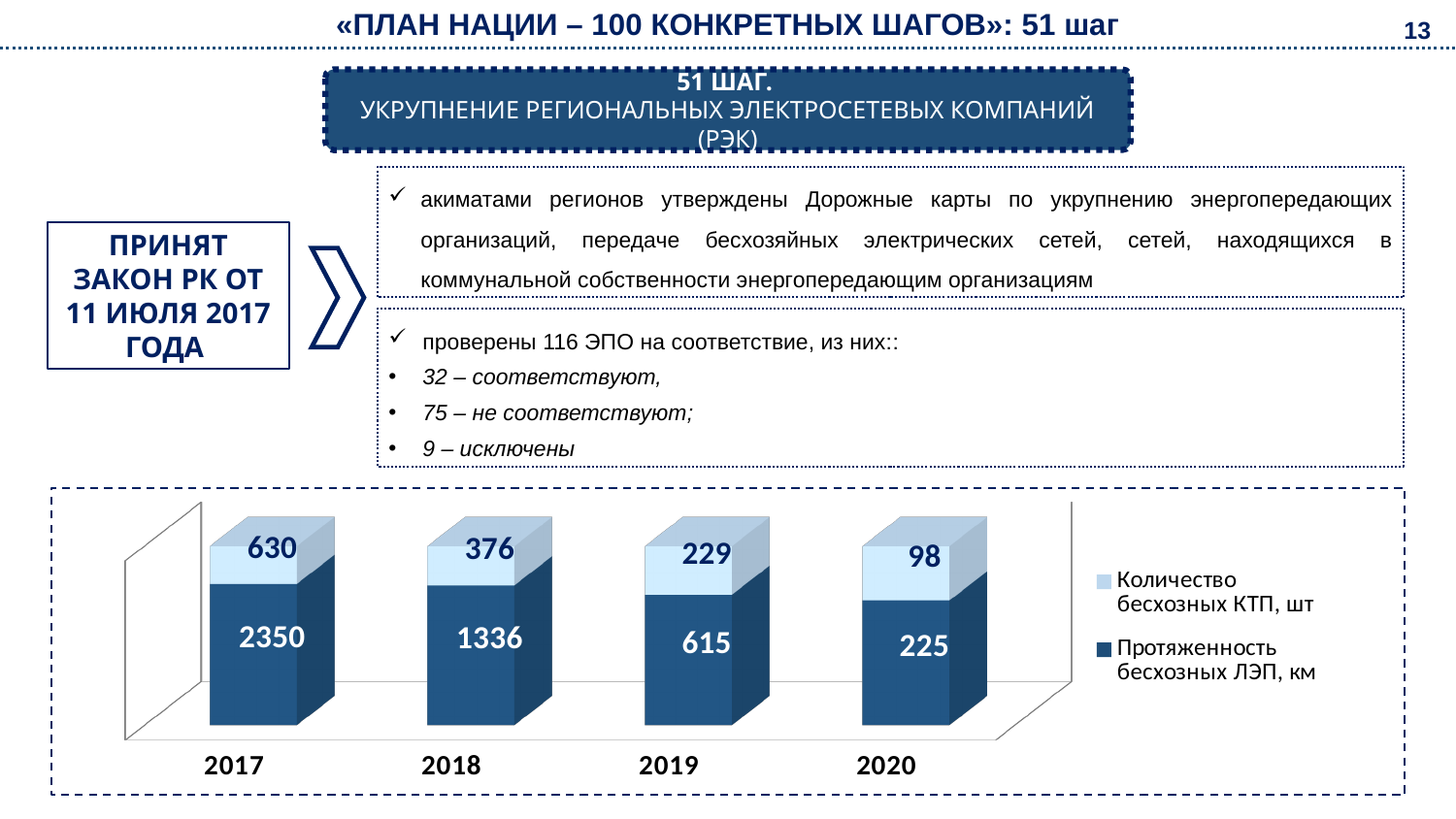
Which year has the lowest value for "Количество бесхозных КТП, шт"? 2020 What is the difference between the "Протяженность бесхозных ЛЭП, км" values for 2017 and 2018? 1014 Do the values for "Протяженность бесхозных ЛЭП, км" rise or fall from 2017 to 2020? Fall What is the value of "Количество бесхозных КТП, шт" for 2019? 229 How many series does the chart legend list? 2 What is the total of the stacked bar for 2020? 323 Which is larger: "Количество бесхозных КТП, шт" in 2018 or in 2019? 2018 What is the value of "Протяженность бесхозных ЛЭП, км" for 2017? 2350 Which year has the highest value for "Протяженность бесхозных ЛЭП, км"? 2017 How many years are shown on the x axis of the chart? 4 What kind of chart is shown at the bottom of the slide? Stacked bar chart What is the value of "Количество бесхозных КТП, шт" for 2020? 98